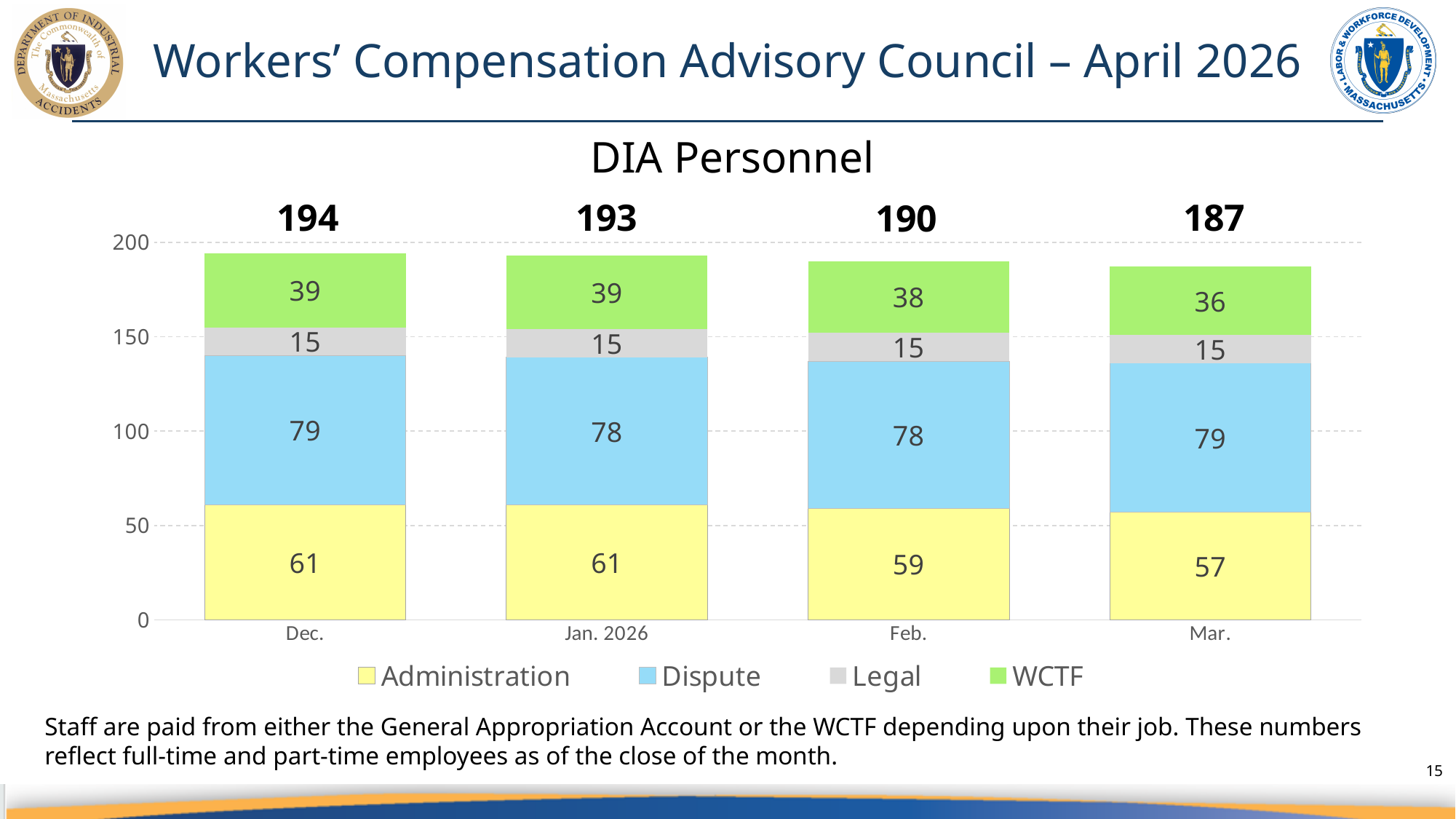
What is the Administration value for Mar.? 57 What is the difference between the total for Dec. and the total for Mar.? 7 What is the total of the stacked bar for Dec.? 194 Which month has the lowest total personnel? Mar. Is the WCTF value for Dec. larger or smaller than the WCTF value for Mar.? larger Do the total personnel values rise or fall from Dec. to Mar.? fall What kind of chart is shown? stacked bar chart What is the Dispute value for Jan. 2026? 78 Which month has the highest total personnel? Dec. How many months are shown on the x axis? 4 What is the WCTF value for Feb.? 38 How many series does the legend list? 4